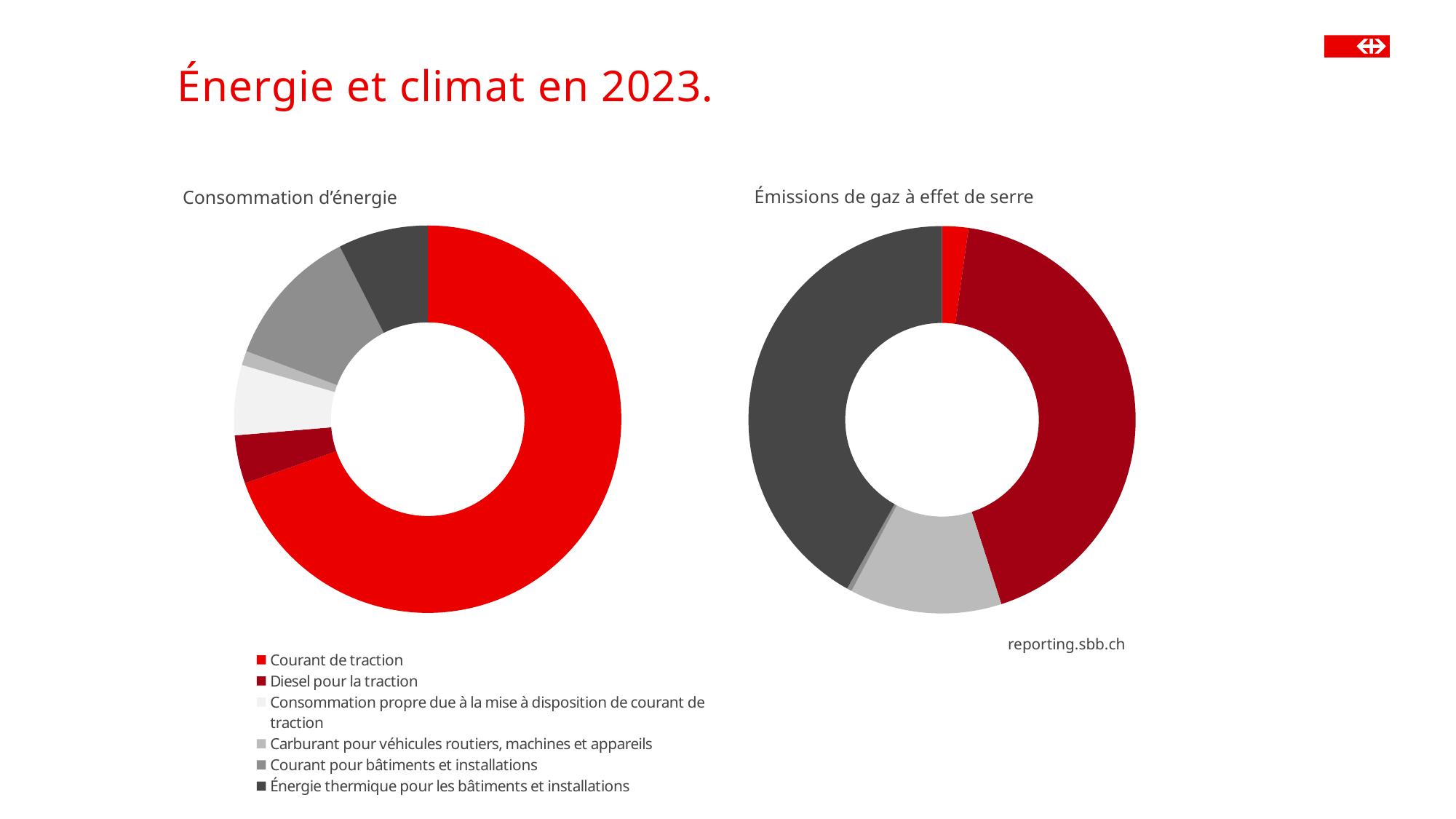
What kind of chart is the 'Consommation d'énergie' chart? Donut (pie) chart What kind of chart is the 'Émissions de gaz à effet de serre' chart? Donut (pie) chart How many categories does the legend list? 6 In the 'Consommation d'énergie' chart, which category has the largest slice? Courant de traction In the 'Consommation d'énergie' chart, which is larger: Courant pour bâtiments et installations or Carburant pour véhicules routiers, machines et appareils? Courant pour bâtiments et installations In the 'Émissions de gaz à effet de serre' chart, which is larger: Énergie thermique pour les bâtiments et installations or Courant pour bâtiments et installations? Énergie thermique pour les bâtiments et installations In the 'Émissions de gaz à effet de serre' chart, which is larger: Diesel pour la traction or Courant de traction? Diesel pour la traction In the 'Consommation d'énergie' chart, which category has the smallest slice? Carburant pour véhicules routiers, machines et appareils What is the title of the chart on the right? Émissions de gaz à effet de serre How many charts are shown on the slide? 2